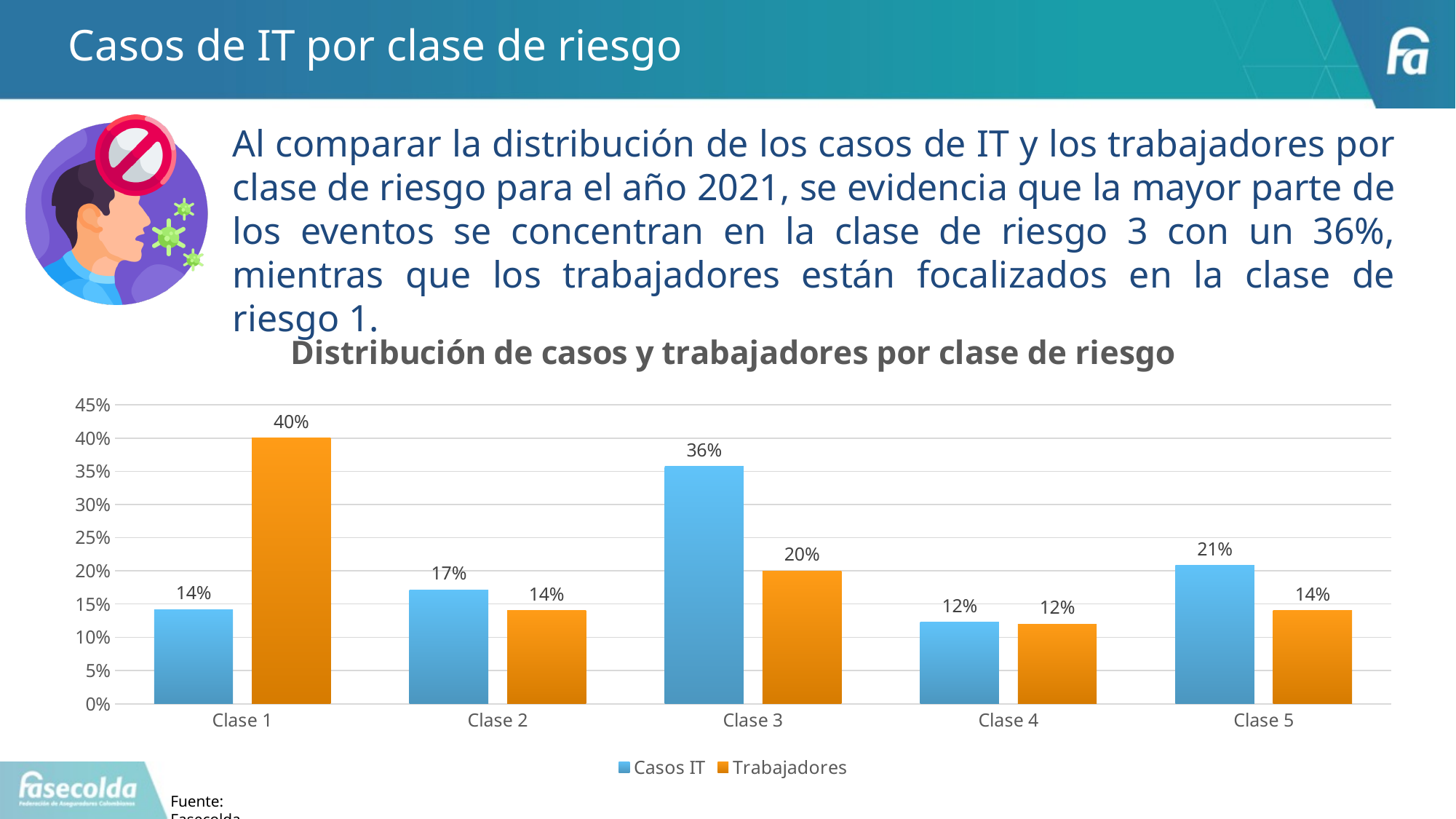
What is the title of the chart? Distribución de casos y trabajadores por clase de riesgo What kind of chart is shown on the slide? Bar chart How many series does the legend list? 2 Which class has the lowest value for Casos IT? Clase 4 Is the value for Casos IT in Clase 2 greater or less than 15%? greater What is the value for Trabajadores in Clase 1? 40% How many risk classes are shown on the x axis? 5 What is the difference between Trabajadores and Casos IT in Clase 1? 26% Which class has the highest value for Trabajadores? Clase 1 What is the value for Casos IT in Clase 5? 21% What is the value for Casos IT in Clase 3? 36% Which is larger in Clase 3, Casos IT or Trabajadores? Casos IT